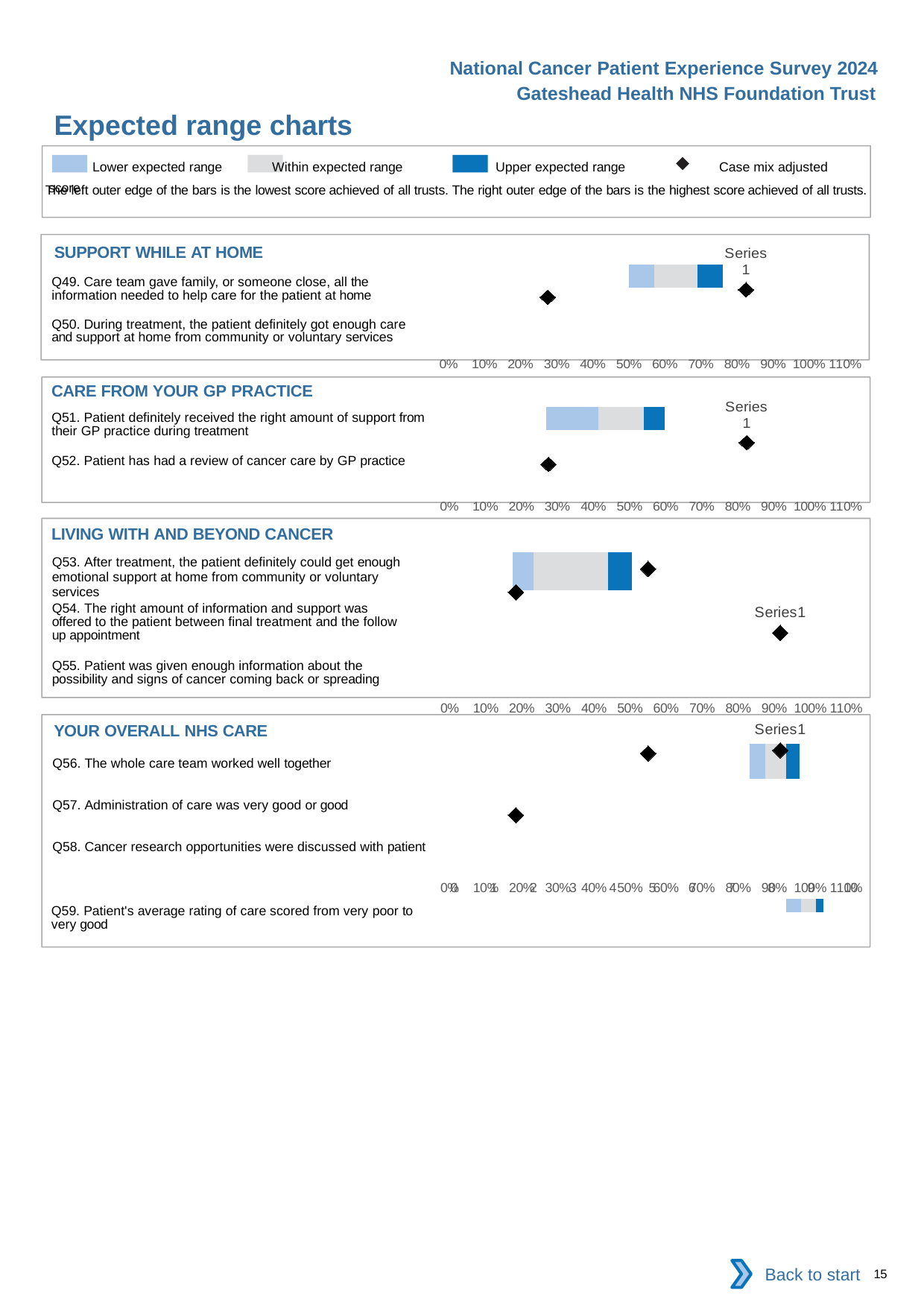
How many questions are listed in the YOUR OVERALL NHS CARE chart? 4 How many entries does the legend at the top of the slide list? 4 In the SUPPORT WHILE AT HOME chart, is the left edge of the expected range bar greater or less than 40%? greater How many questions are listed in the LIVING WITH AND BEYOND CANCER chart? 3 Which legend entry is shown with a dark blue colour? Upper expected range What is the title of the slide? Expected range charts What kind of chart is used in the SUPPORT WHILE AT HOME section? Bar chart In the CARE FROM YOUR GP PRACTICE chart, is the right edge of the expected range bar greater or less than 50%? greater How many questions are listed in the CARE FROM YOUR GP PRACTICE chart? 2 What is the highest value shown on the x axis of the SUPPORT WHILE AT HOME chart? 110%